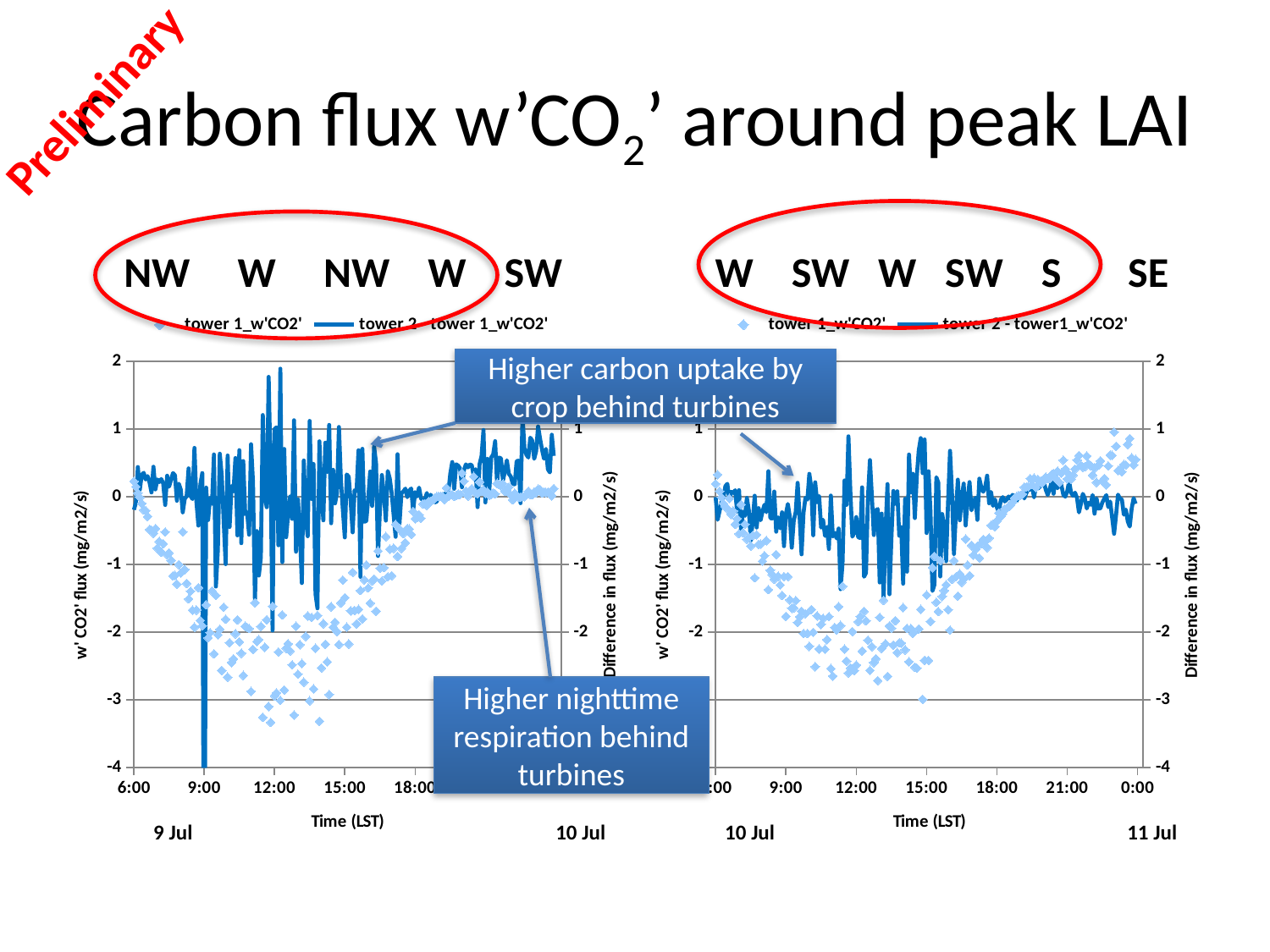
On the right chart (10 Jul to 11 Jul), how many series does the legend list? 2 On the right chart (10 Jul to 11 Jul), what is the title of the secondary (right-hand) y axis? Difference in flux (mg/m2/s) On the left chart (9 Jul to 10 Jul), do the tower 1_w'CO2' values rise or fall between 6:00 and 9:00? fall On the left chart (9 Jul to 10 Jul), what is the title of the x axis? Time (LST) On the right chart (10 Jul to 11 Jul), how many time labels are shown along the x axis? 7 On the right chart (10 Jul to 11 Jul), is the tower 1_w'CO2' value at around 21:00 greater or less than -1? greater On the left chart (9 Jul to 10 Jul), is the tower 1_w'CO2' value at around 12:00 greater or less than -1? less On the right chart (10 Jul to 11 Jul), is the tower 1_w'CO2' value at around 12:00 greater or less than -1? less On the right chart (10 Jul to 11 Jul), do the tower 1_w'CO2' values rise or fall between 12:00 and 21:00? rise On the left chart (9 Jul to 10 Jul), how many series does the legend list? 2